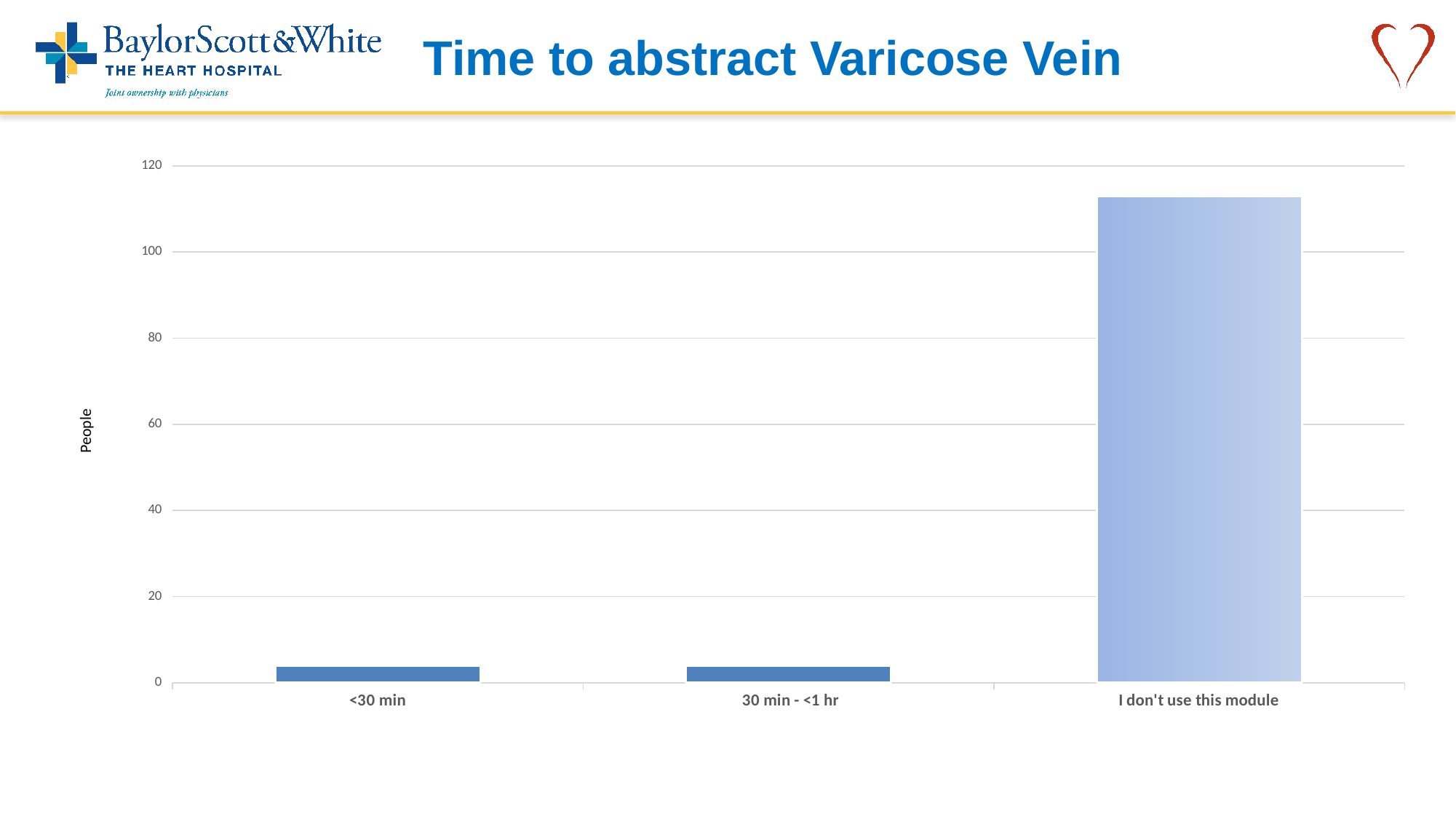
Which is larger, the value for "I don't use this module" or the value for "<30 min"? I don't use this module What kind of chart is shown on the slide? bar chart What is the title of the slide containing the chart? Time to abstract Varicose Vein Which is larger, the value for "30 min - <1 hr" or the value for "I don't use this module"? I don't use this module What is the label on the vertical axis of the chart? People Is the value for "30 min - <1 hr" greater or less than 20? less Which category has the highest value in the chart? I don't use this module Is the value for "I don't use this module" greater or less than 100? greater How many categories are shown on the x axis of the chart? 3 Is the value for "I don't use this module" greater or less than 120? less